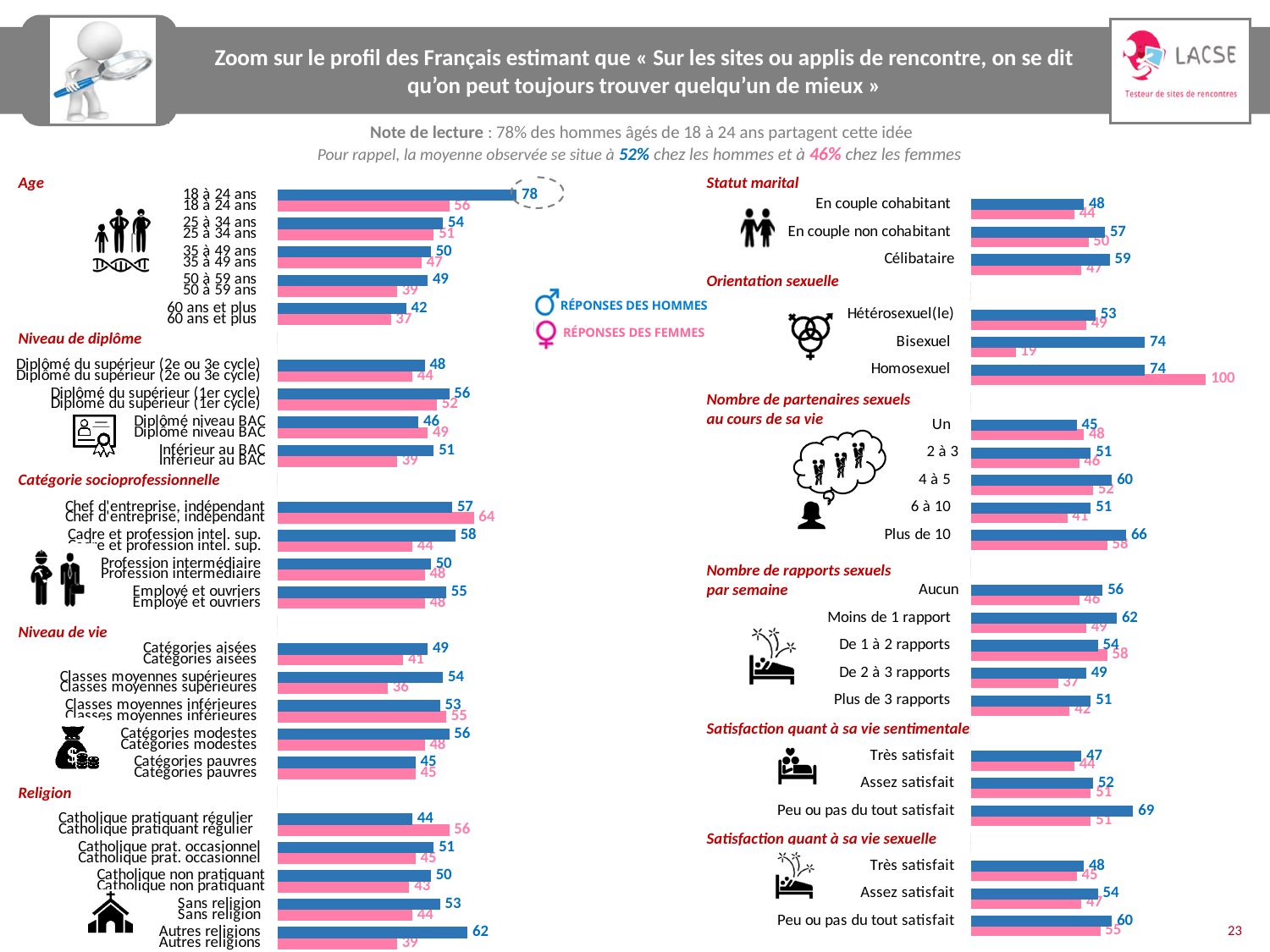
How many categories does the Statut marital chart show? 3 In the Nombre de partenaires sexuels au cours de sa vie chart, what is the men's value for Plus de 10? 66 In the Satisfaction quant à sa vie sentimentale chart, what is the difference between the men's and women's values for Peu ou pas du tout satisfait? 18 In the Age chart, what is the value for men (Réponses des hommes) aged 18 à 24 ans? 78 In the Orientation sexuelle chart, what is the difference between the men's and women's values for Bisexuel? 55 In the Niveau de vie chart, which category has the lowest value for women (Réponses des femmes)? Classes moyennes supérieures What type of chart is used for the Age section? bar chart In the Catégorie socioprofessionnelle chart, which is larger for Chef d'entreprise, indépendant: the men's value or the women's value? the women's value In the Orientation sexuelle chart, what is the value for women (Réponses des femmes) in the Homosexuel category? 100 In the Age chart, what is the value for women (Réponses des femmes) aged 50 à 59 ans? 39 In the Religion chart, which category has the highest value for men (Réponses des hommes)? Autres religions How many series does the legend list (Réponses des hommes / Réponses des femmes)? 2